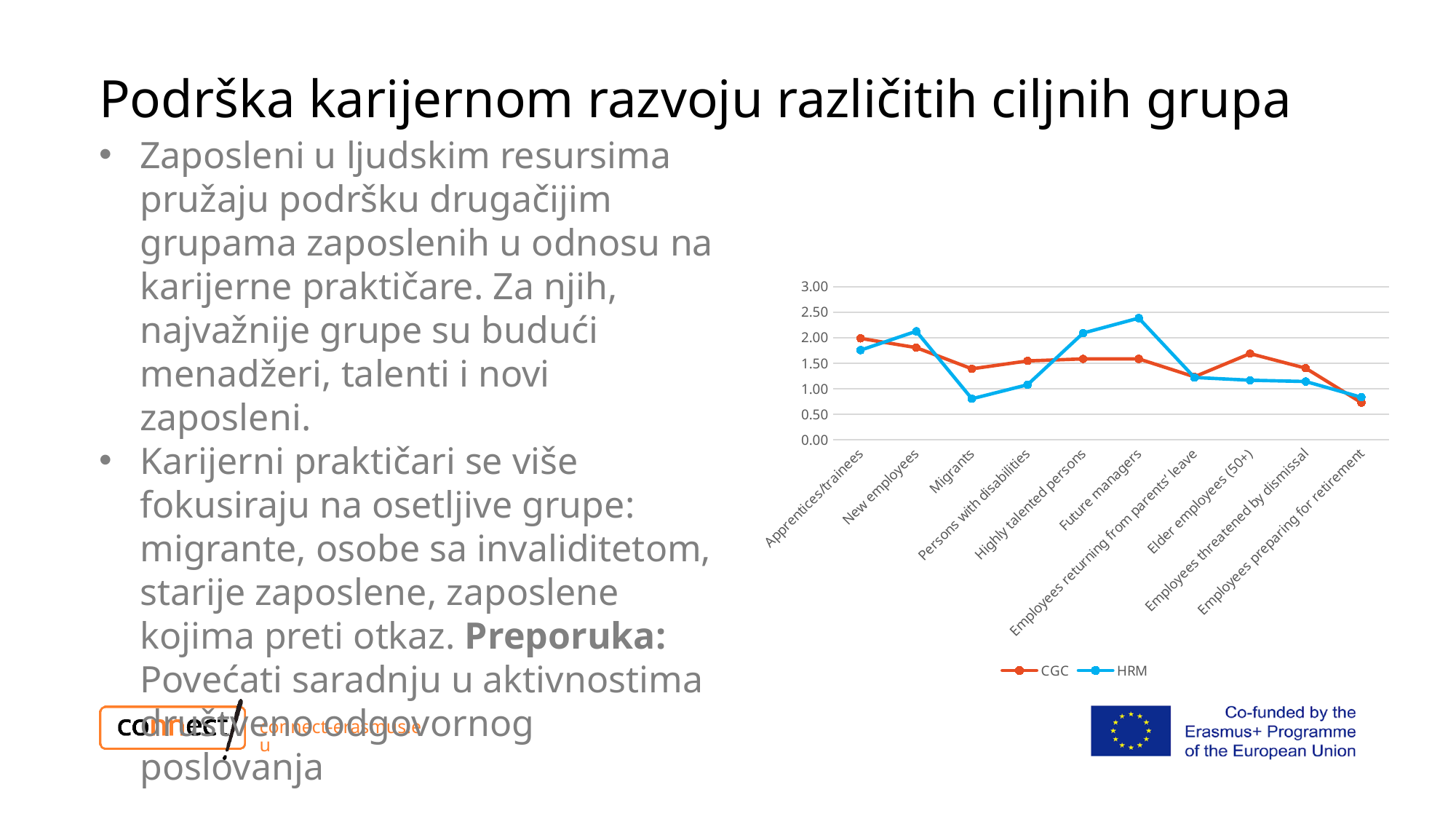
What are the two series names listed in the chart's legend? CGC and HRM For which category does the CGC series have its lowest value? Employees preparing for retirement How many series does the chart's legend list? 2 Which series has the larger value for Migrants, CGC or HRM? CGC How many categories are plotted along the x axis of the chart? 10 For which category does the HRM series reach its highest value? Future managers Is the HRM value for Future managers greater or less than 2.00? greater Does the HRM series rise or fall from Future managers to Employees preparing for retirement? fall Is the CGC value for Elder employees (50+) greater or less than 1.50? greater What kind of chart is shown on the slide? line chart Which series has the larger value for Future managers, CGC or HRM? HRM Is the HRM value for Migrants greater or less than 1.00? less